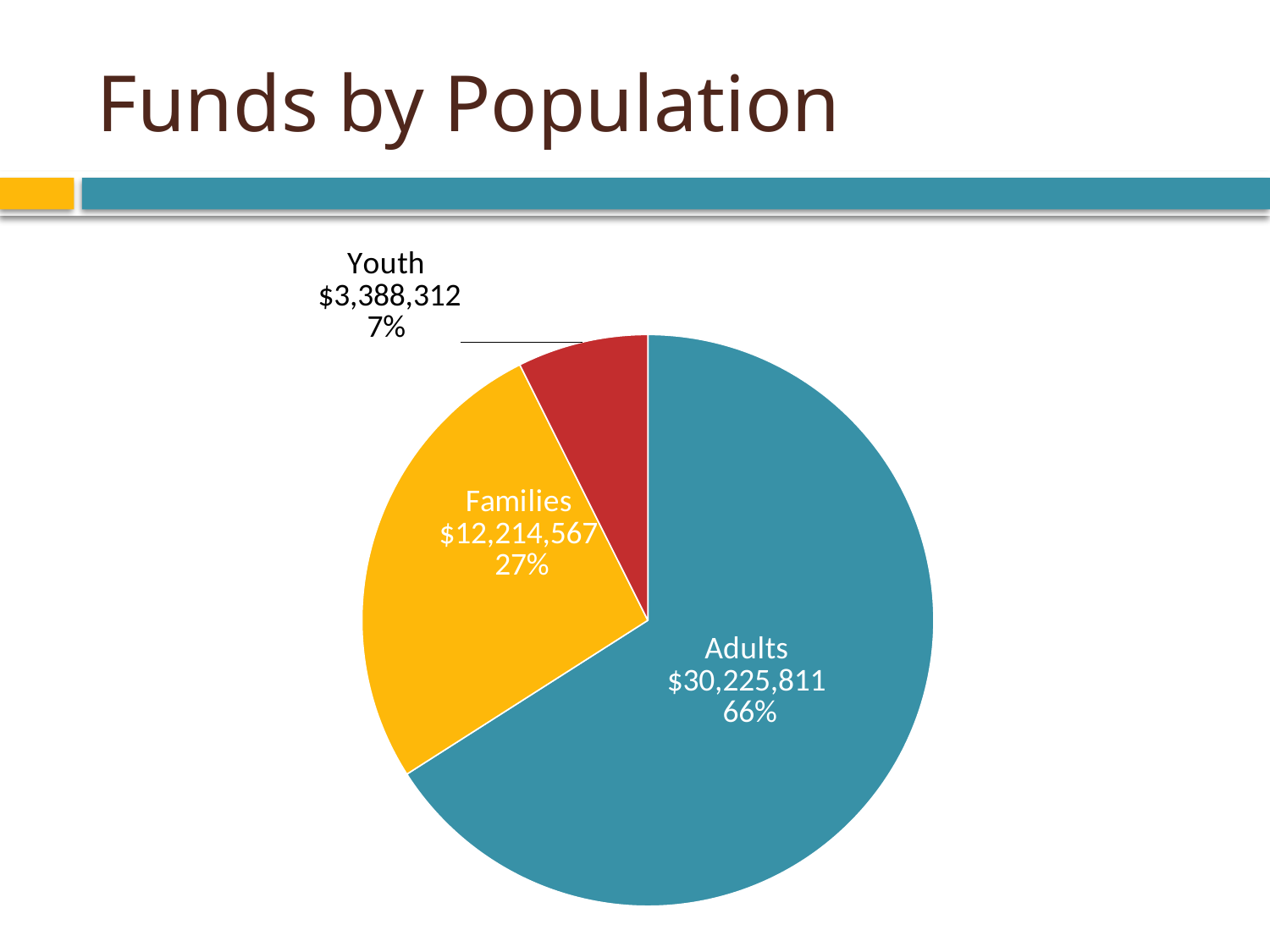
What kind of chart is shown on the slide? Pie chart Which population receives the smallest share of funds? Youth What is the dollar value for Adults? $30,225,811 Which population receives the largest share of funds? Adults What percentage of funds goes to Families? 27% How much more funding do Adults receive than Families? $18,011,244 How many slices does the pie chart have? 3 What is the title of the chart? Funds by Population What is the dollar value for Youth? $3,388,312 Which slice is larger, Families or Youth? Families What percentage of funds goes to Youth? 7% What is the dollar value for Families? $12,214,567